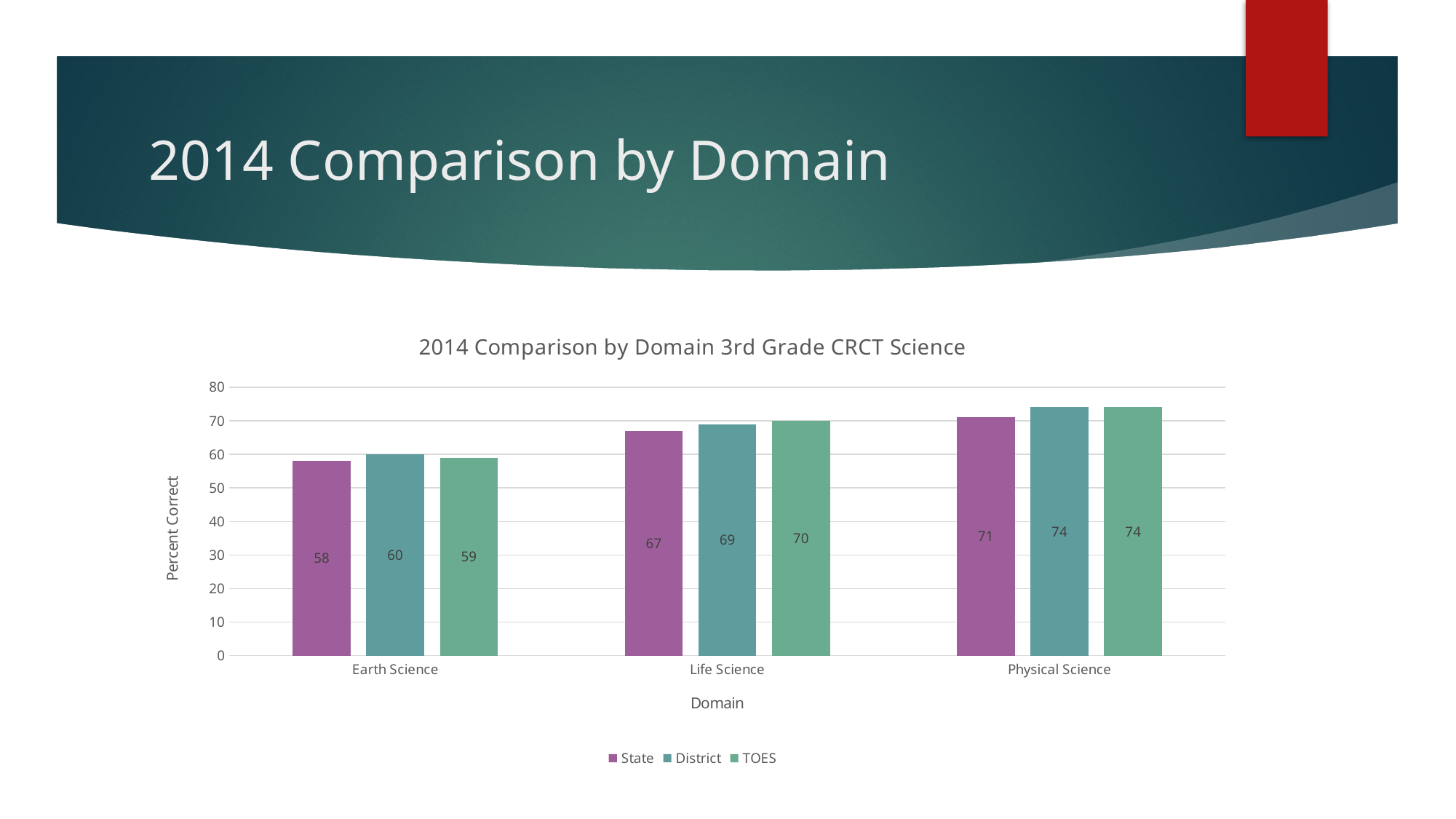
What is the difference between the District and State values for Life Science? 2 How many series does the legend list? 3 What is the District value for Physical Science? 74 Which domain has the lowest TOES value? Earth Science What is the label of the y axis? Percent Correct What is the State value for Earth Science? 58 Is the State value for Physical Science greater or less than 60? greater Which domain has the highest State value? Physical Science For Earth Science, which is larger: the District value or the TOES value? District What kind of chart is shown? bar chart What is the TOES value for Life Science? 70 How many domains are shown on the x axis? 3